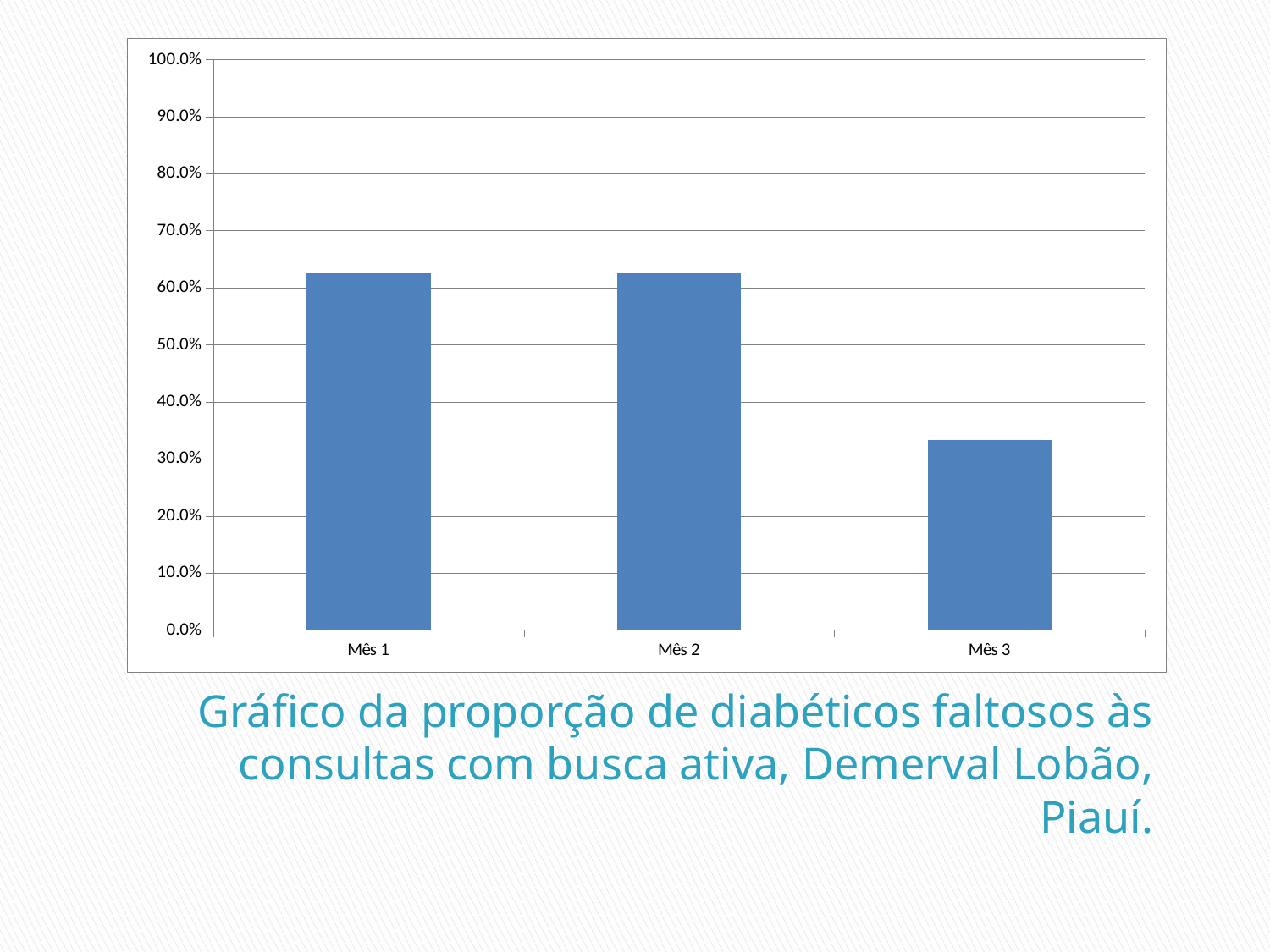
How many categories (months) are plotted on the chart? 3 Do the values rise or fall from Mês 2 to Mês 3? fall Is the value for Mês 2 greater or less than 70.0%? less Which is larger, the value for Mês 2 or the value for Mês 3? Mês 2 Is the value for Mês 3 greater or less than 40.0%? less Which month has the lowest value on the chart? Mês 3 Which is larger, the value for Mês 1 or the value for Mês 3? Mês 1 Is the value for Mês 1 greater or less than 60.0%? greater What is the highest value shown on the vertical axis of the chart? 100.0% According to the caption, which municipality and state does the chart refer to? Demerval Lobão, Piauí What kind of chart is shown on the slide? bar chart